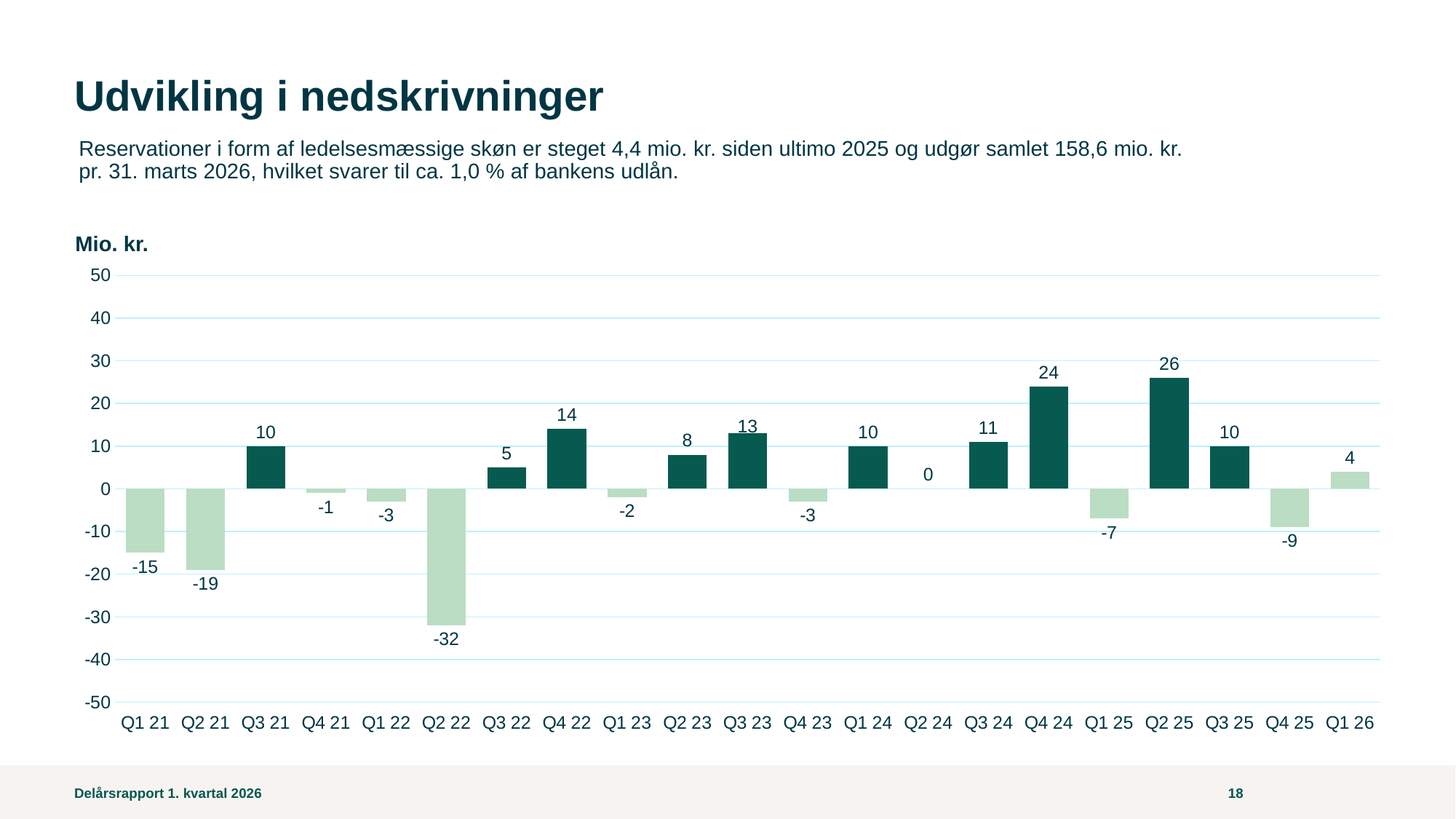
What is the difference between the values for Q1 26 and Q4 25? 13 What kind of chart is shown on the slide? Bar chart Do the values rise or fall from Q4 25 to Q1 26? Rise How many quarters are shown on the x axis? 21 What is the value for Q2 24? 0 What is the value for Q2 22? -32 What unit is shown above the y axis of the chart? Mio. kr. Which quarter has the lowest value? Q2 22 What is the difference between the values for Q2 25 and Q4 24? 2 Which quarter has the highest value? Q2 25 What is the value for Q1 26? 4 Which is larger, the value for Q4 22 or the value for Q3 23? Q4 22